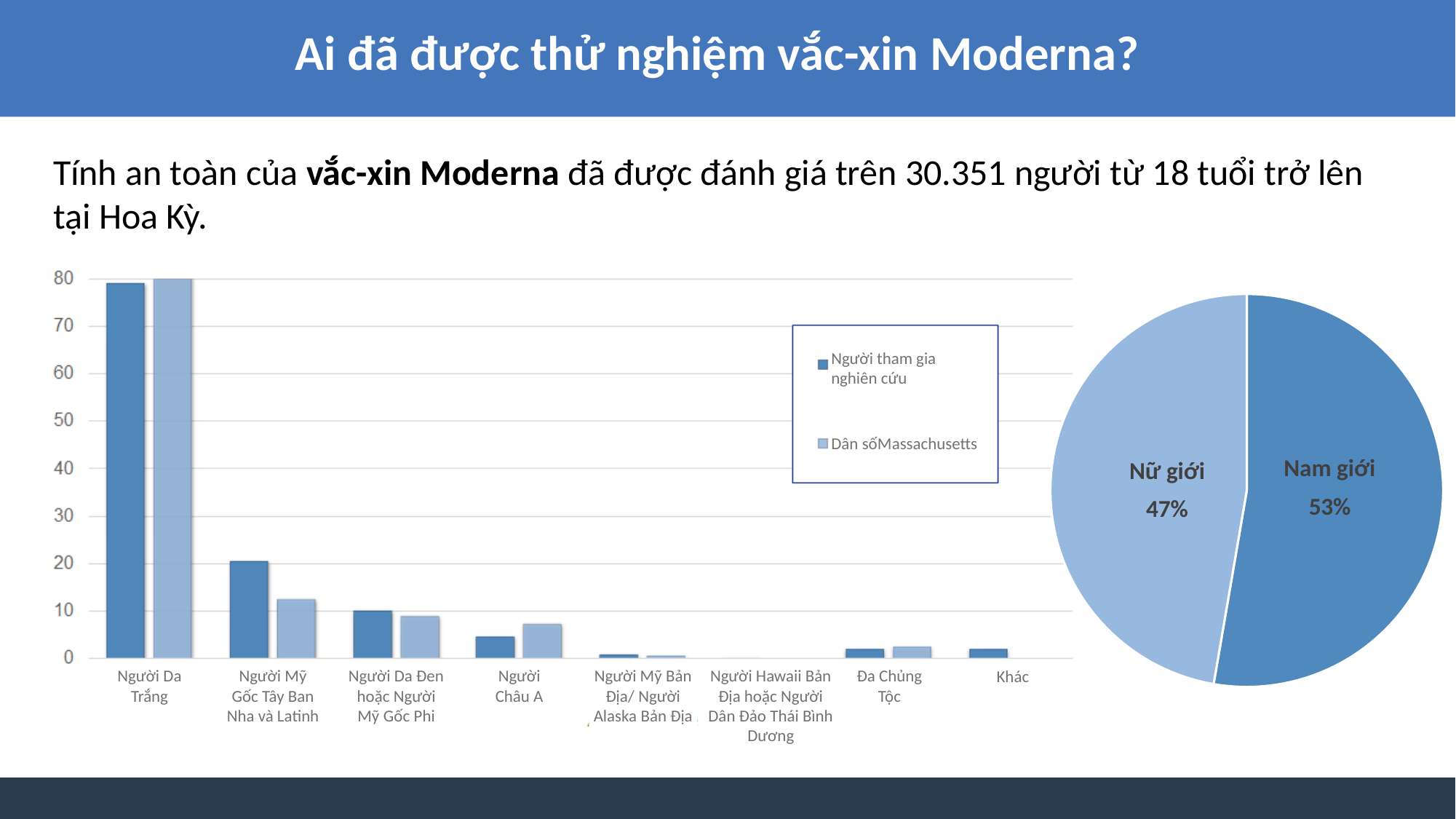
In the bar chart on the left, for Người Châu A, which series has the larger value, Người tham gia nghiên cứu or Dân số Massachusetts? Dân số Massachusetts In the bar chart on the left, which category has the highest value for Người tham gia nghiên cứu? Người Da Trắng In the pie chart on the right, what share is labelled for Nữ giới? 47% In the bar chart on the left, is the value for Người Da Trắng in the Người tham gia nghiên cứu series greater or less than 70? greater In the bar chart on the left, how many series does the legend list? 2 In the pie chart on the right, which slice is larger, Nữ giới or Nam giới? Nam giới In the bar chart on the left, how many categories are shown on the x axis? 8 What kind of chart is the chart on the left of the slide? Bar chart In the bar chart on the left, is the value for Người Mỹ Gốc Tây Ban Nha và Latinh in the Người tham gia nghiên cứu series greater or less than 10? greater In the pie chart on the right, how many slices are there? 2 In the pie chart on the right, what share is labelled for Nam giới? 53% In the pie chart on the right, what is the difference in percentage points between Nam giới and Nữ giới? 6%